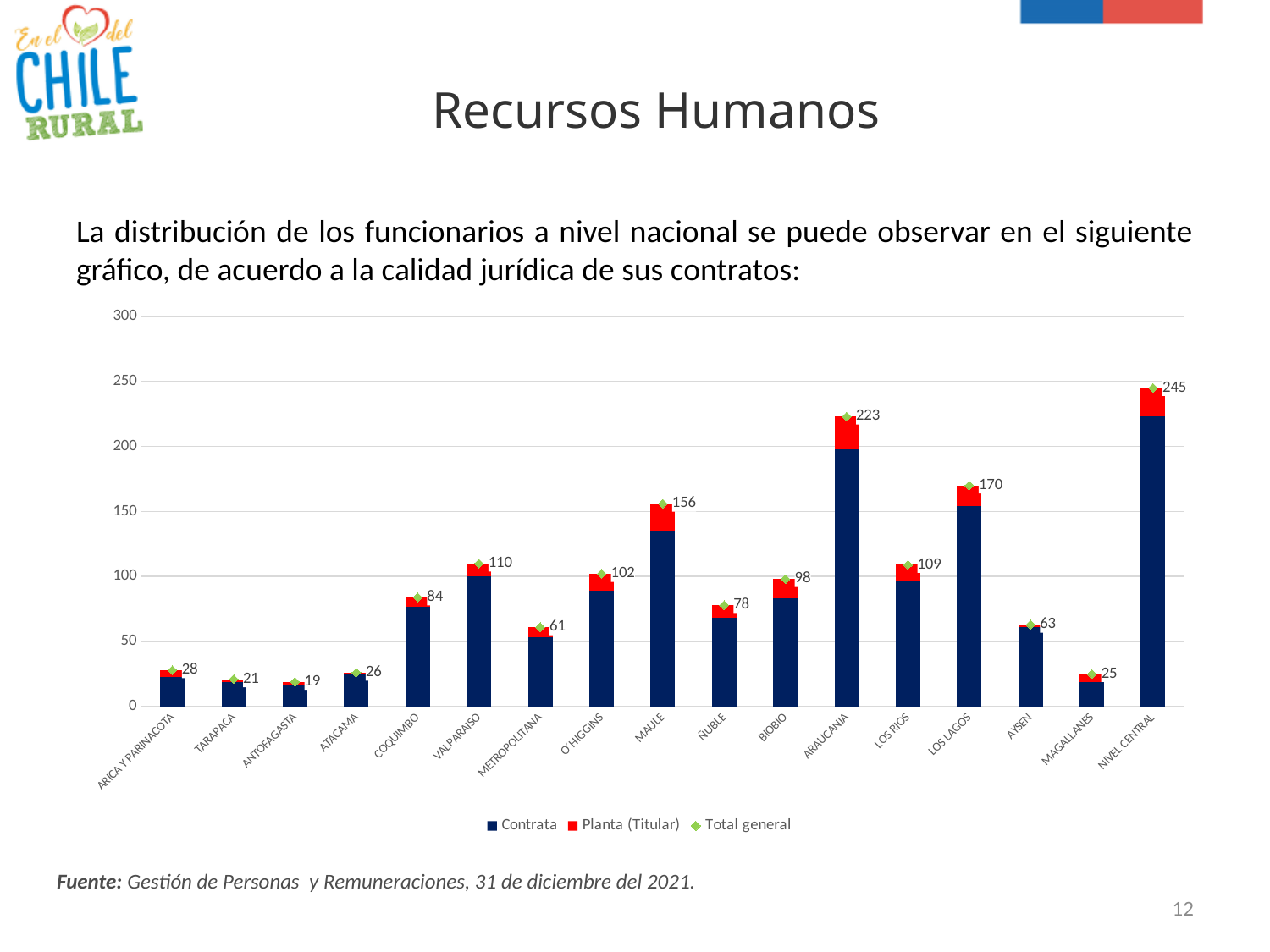
How many series does the legend list? 3 Is the Contrata value for MAULE greater or less than 100? greater Which category has the lowest Total general value? ANTOFAGASTA Is the Contrata value for NIVEL CENTRAL greater or less than 200? greater Which category has the highest Total general value? NIVEL CENTRAL Which has a larger Total general value, MAULE or LOS LAGOS? LOS LAGOS How many categories are shown on the x axis? 17 What kind of chart is shown on the slide? Stacked bar chart What is the Total general value for COQUIMBO? 84 What is the Total general value for ARAUCANIA? 223 What is the difference between the Total general values for NIVEL CENTRAL and ARAUCANIA? 22 What is the Total general value for MAGALLANES? 25